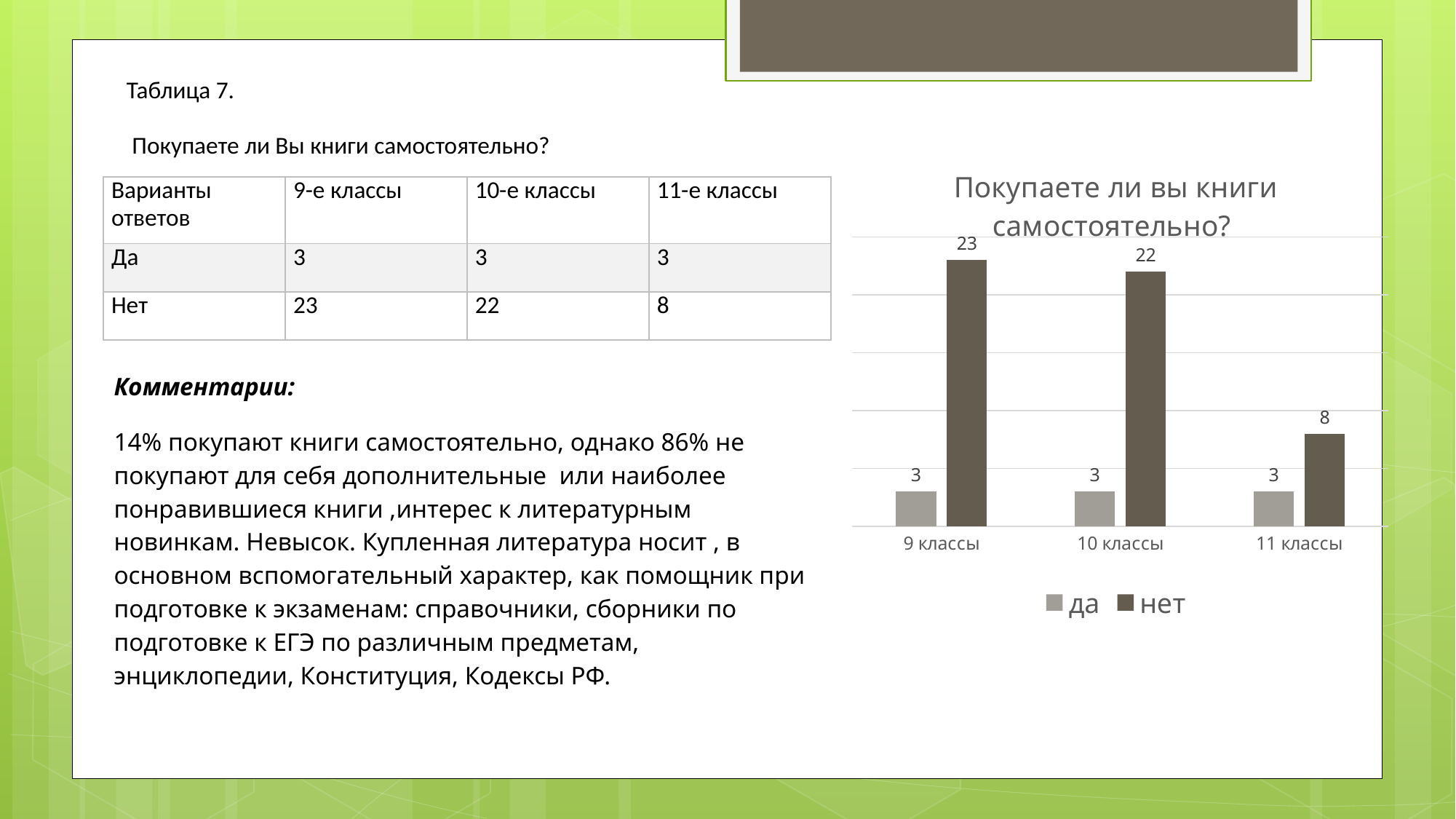
What is the difference between the "нет" and "да" values for 10 классы? 19 What is the difference between the "нет" values for 9 классы and 11 классы? 15 What kind of chart is shown? bar chart Which is larger for 11 классы, "да" or "нет"? нет What is the value for "нет" for 11 классы? 8 Which category has the highest value for "нет"? 9 классы Which category has the lowest value for "нет"? 11 классы What is the title of the chart? Покупаете ли вы книги самостоятельно? How many categories are shown on the x axis? 3 What is the value for "да" for 10 классы? 3 How many series does the legend list? 2 What is the value for "нет" for 9 классы? 23